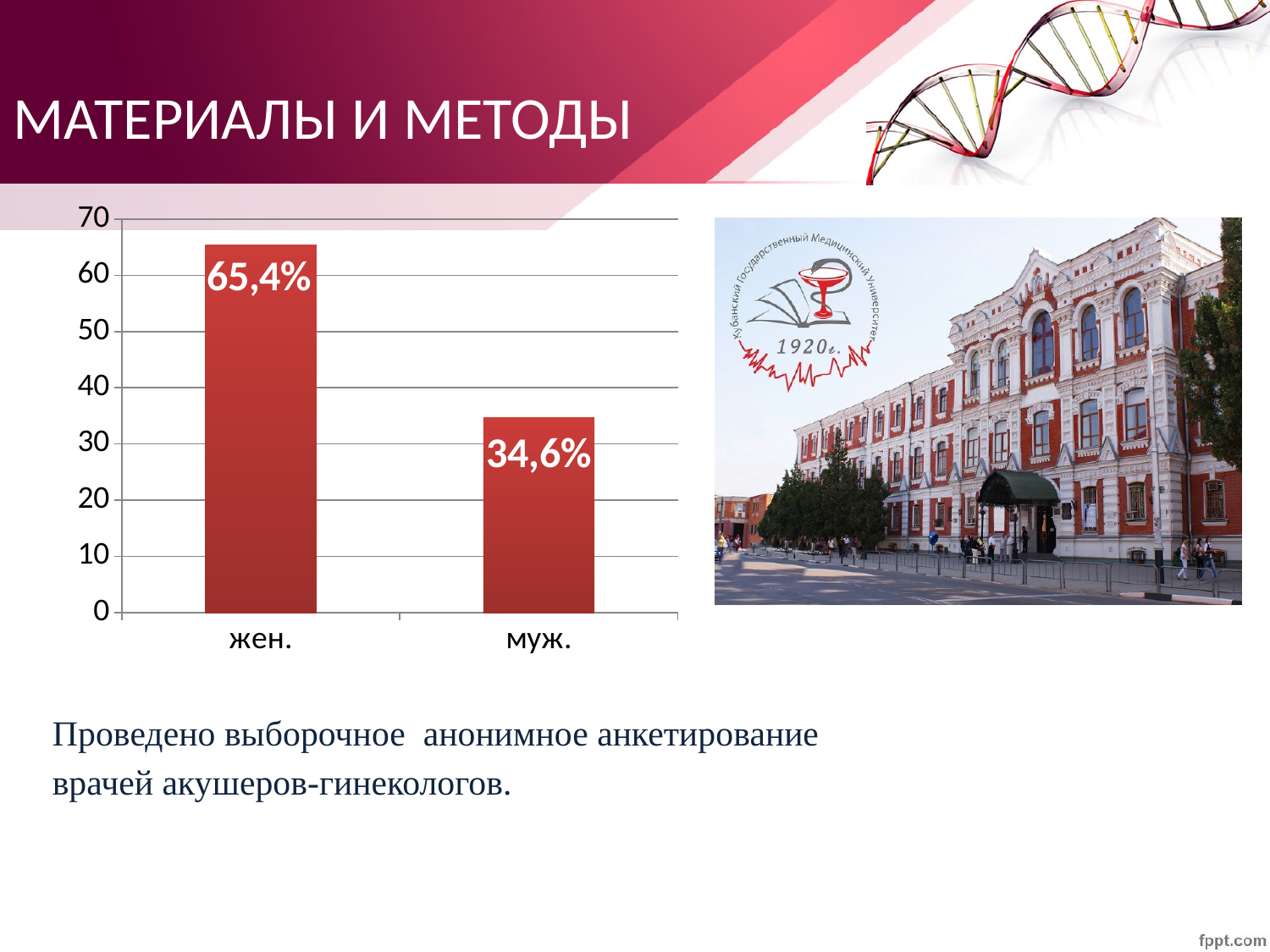
What kind of chart is shown on the slide? bar chart What colour are the bars in the chart? red Which is larger, the value for жен. or the value for муж.? жен. How many categories are shown on the chart? 2 What is the maximum value shown on the vertical axis? 70 What is the difference between the values for жен. and муж.? 30,8% Which category has the lowest value? муж. What is the value for муж.? 34,6% Is the value for жен. greater or less than 60? greater Which category has the highest value? жен. What is the value for жен.? 65,4% Is the value for муж. greater or less than 40? less